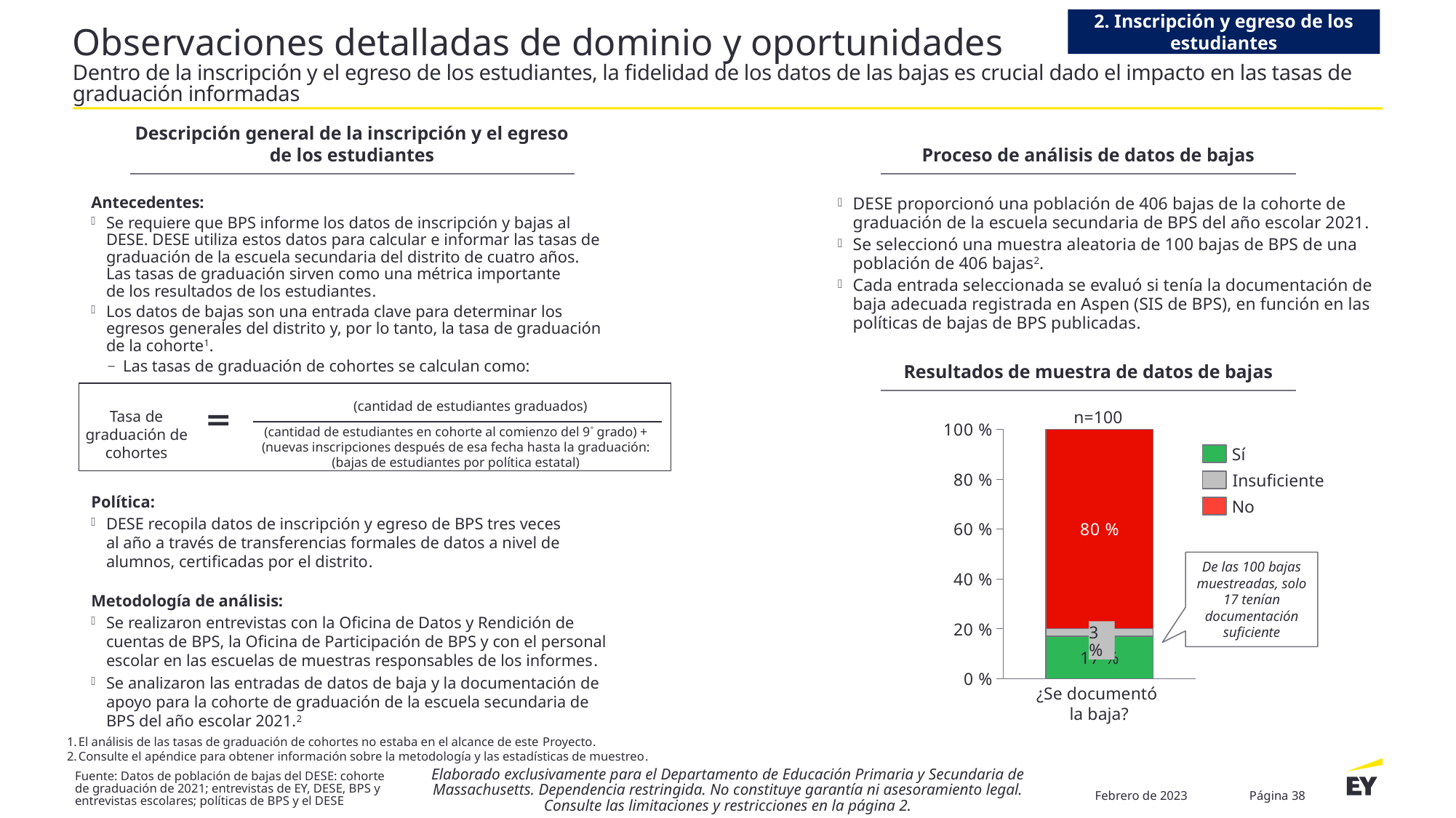
How many series does the legend list? 3 What percentage of sampled withdrawals were documented ("Sí")? 17 % Which is larger, the "Sí" segment or the "Insuficiente" segment? Sí What is the difference between the "No" share and the "Sí" share? 63 % Which segment of the stacked bar is the largest? No Which segment of the stacked bar is the smallest? Insuficiente What percentage of sampled withdrawals had no documentation ("No") in the chart? 80 % What percentage of sampled withdrawals had insufficient documentation ("Insuficiente")? 3 % What is the sample size (n) shown above the bar? n=100 What kind of chart is shown under "Resultados de muestra de datos de bajas"? Stacked bar chart What colour represents the "No" series in the chart? Red Is the value for "No" greater or less than 60 %? greater